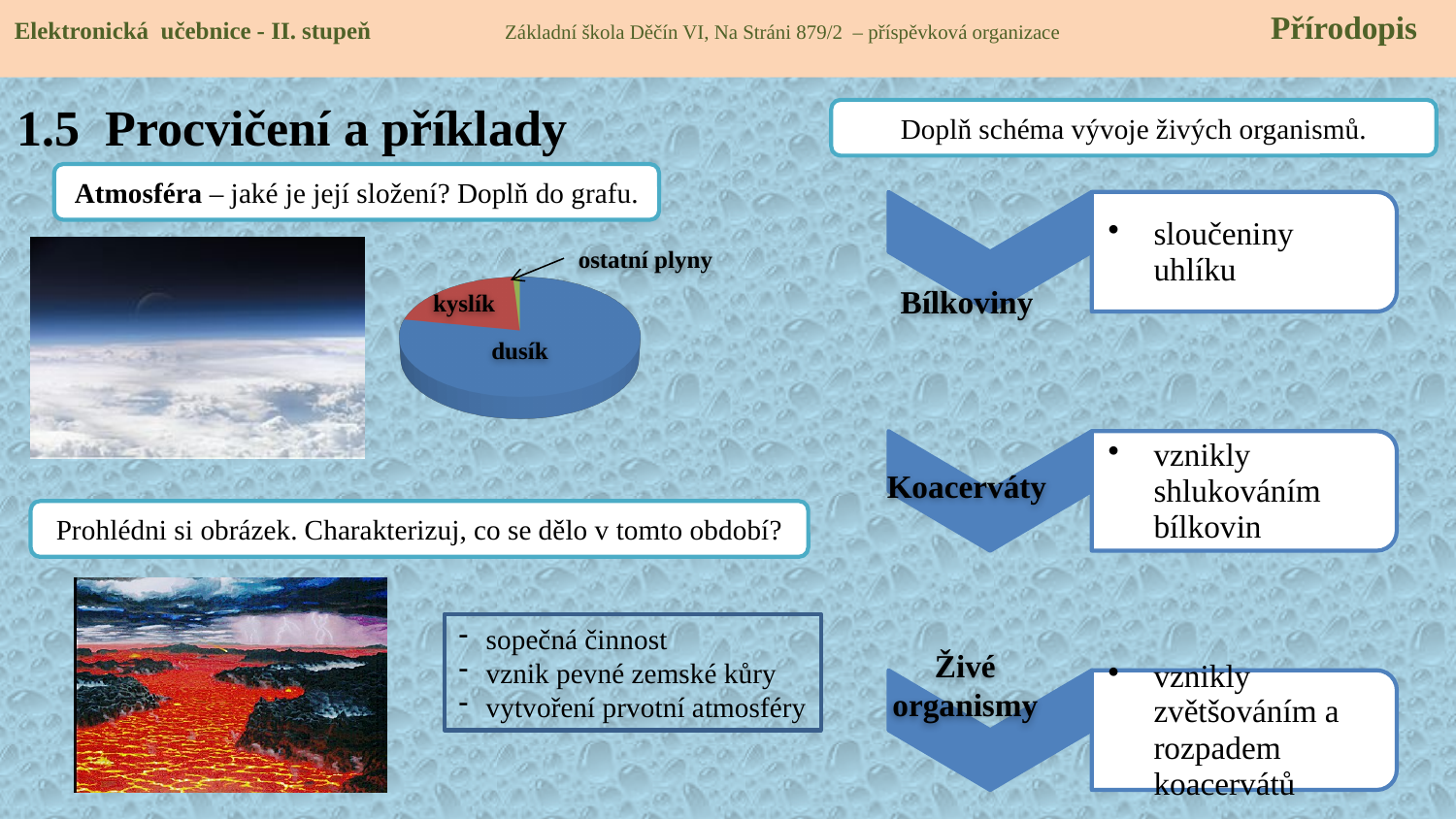
Which slice of the pie chart is the largest? dusík Which slice is larger in the pie chart, kyslík or dusík? dusík How many slices does the pie chart have? 3 Which slice is larger in the pie chart, kyslík or ostatní plyny? kyslík What colour is the kyslík slice in the pie chart? red Which slice of the pie chart is the smallest? ostatní plyny What kind of chart is shown on the slide? pie chart What colour is the dusík slice in the pie chart? blue